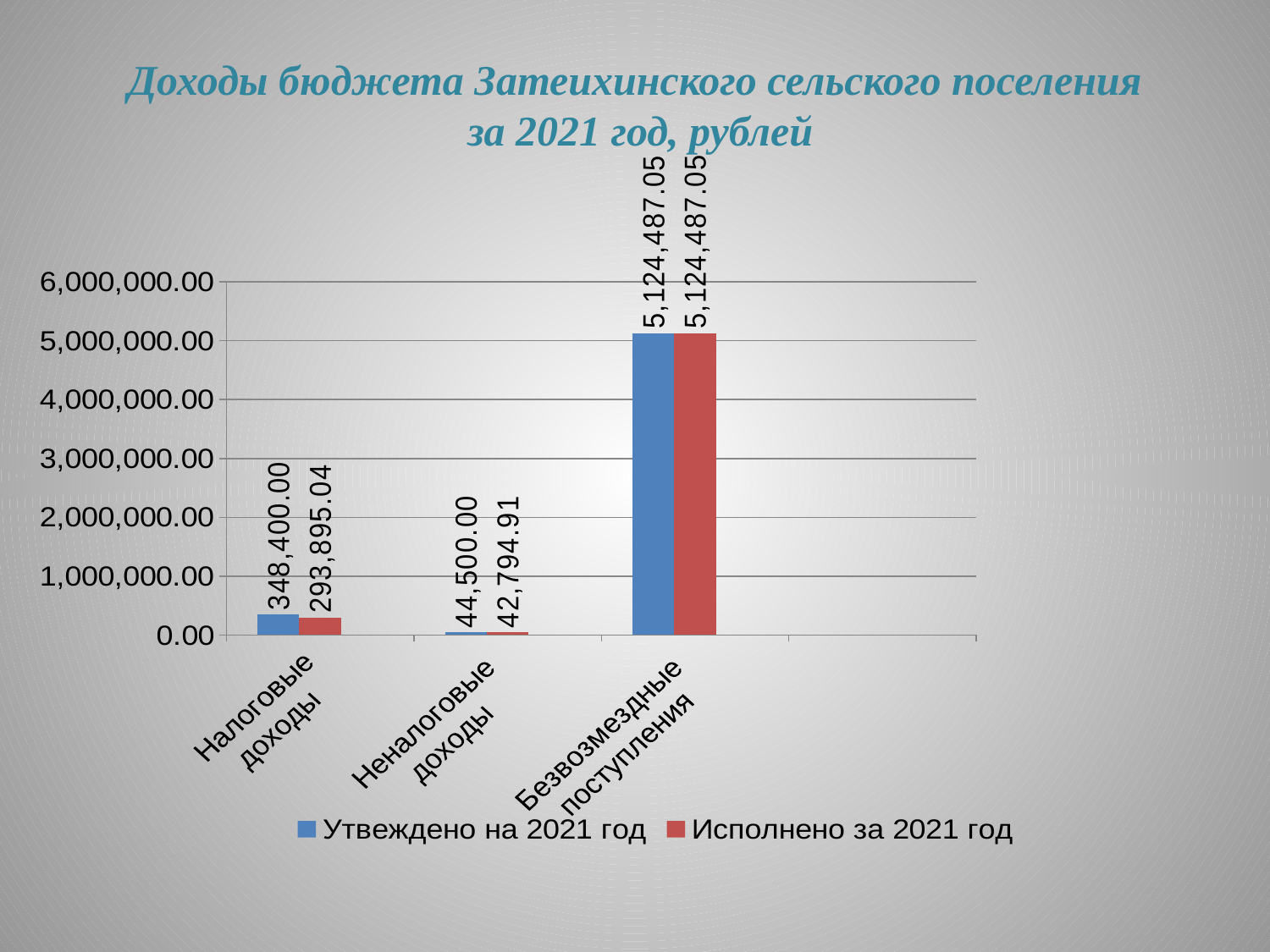
How many series does the legend list? 2 What is the value of 'Исполнено за 2021 год' for 'Налоговые доходы'? 293,895.04 Which category has the lowest value for 'Исполнено за 2021 год'? Неналоговые доходы What is the value of 'Утвеждено на 2021 год' for 'Неналоговые доходы'? 44,500.00 How many categories are shown on the x axis of the chart? 3 What is the value of 'Утвеждено на 2021 год' for 'Налоговые доходы'? 348,400.00 Which category has the highest value for 'Утвеждено на 2021 год'? Безвозмездные поступления What type of chart is shown on the slide? bar chart What is the value of 'Исполнено за 2021 год' for 'Неналоговые доходы'? 42,794.91 What is the value of 'Исполнено за 2021 год' for 'Безвозмездные поступления'? 5,124,487.05 What is the difference between 'Утвеждено на 2021 год' and 'Исполнено за 2021 год' for 'Налоговые доходы'? 54,504.96 Which is larger for 'Неналоговые доходы': 'Утвеждено на 2021 год' or 'Исполнено за 2021 год'? Утвеждено на 2021 год